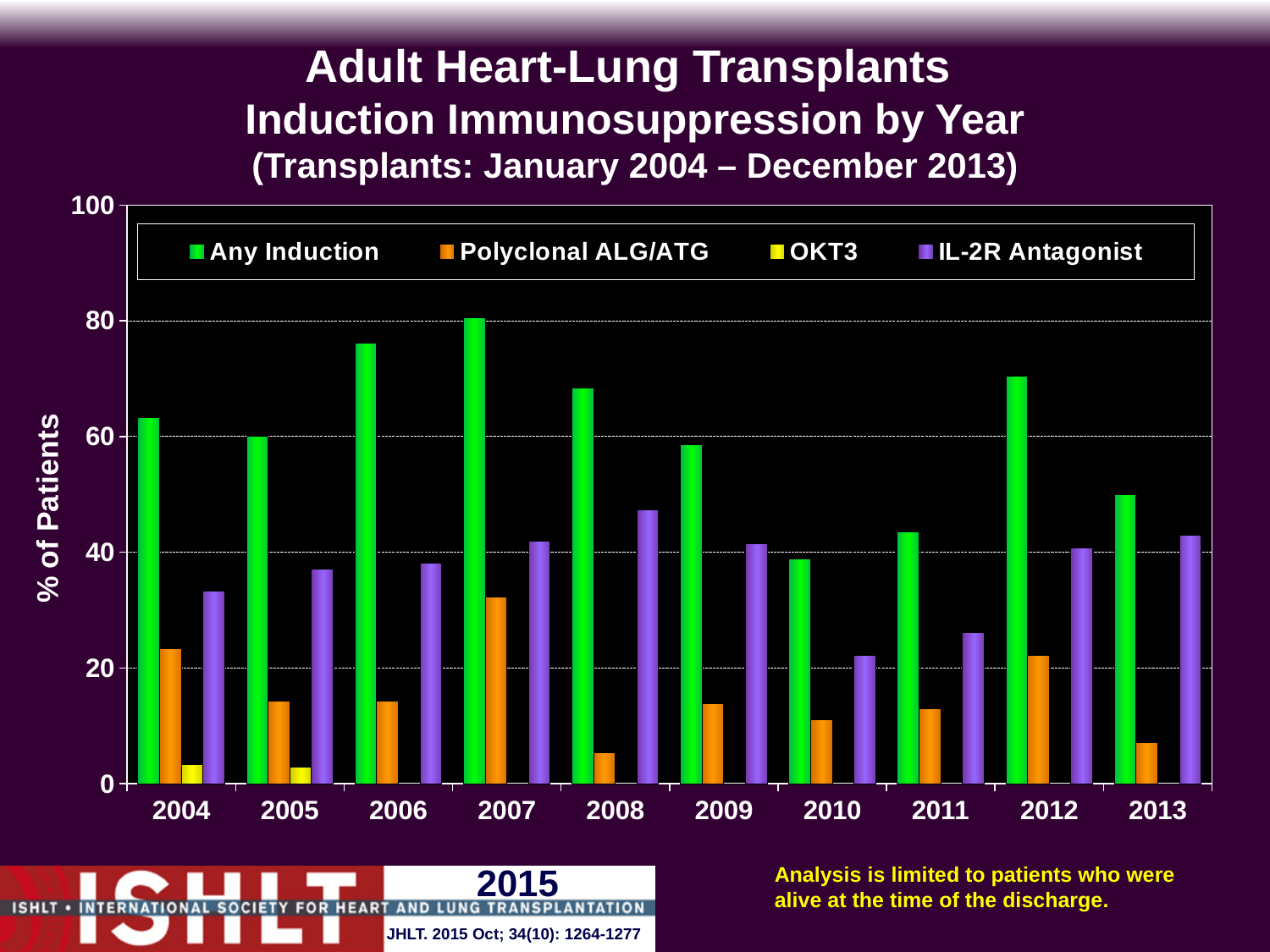
In which year is the Polyclonal ALG/ATG value highest? 2007 How many series does the legend list? 4 In which year is the IL-2R Antagonist value lowest? 2010 In which year is the Any Induction value highest? 2007 What kind of chart is shown on the slide? bar chart In which year is the Any Induction value lowest? 2010 Does the IL-2R Antagonist value rise or fall from 2004 to 2008? rise Is the Any Induction value for 2006 greater or less than 60? greater Is the IL-2R Antagonist value for 2010 greater or less than 40? less How many years are shown along the x axis? 10 In which year is the IL-2R Antagonist value highest? 2008 Which year has the larger Any Induction value, 2012 or 2013? 2012